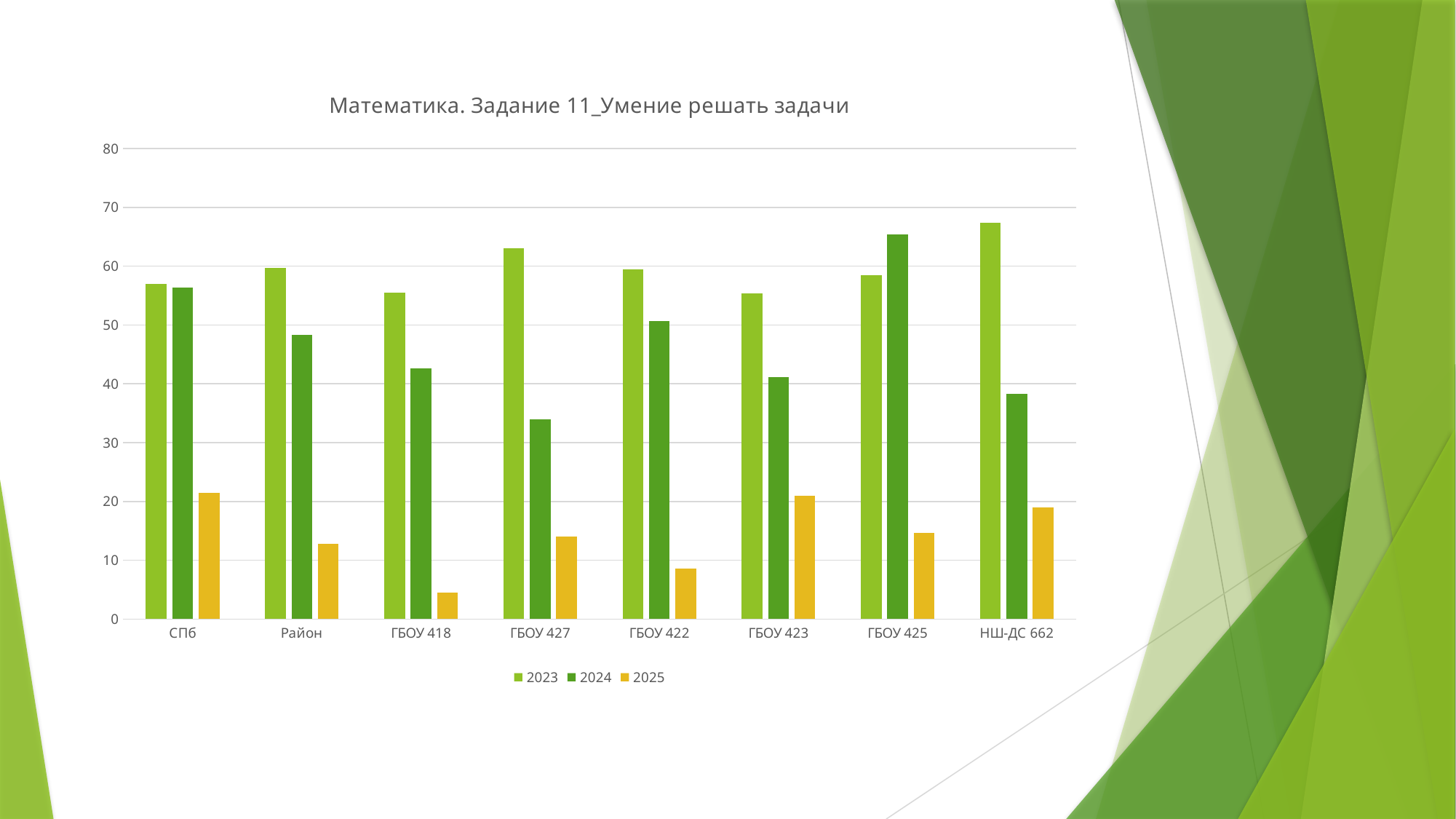
Is the 2025 value for ГБОУ 418 greater or less than 10? less Which category has the highest value for the 2023 series? НШ-ДС 662 Which category has the lowest value for the 2025 series? ГБОУ 418 What kind of chart is shown on the slide? bar chart Which category has the highest value for the 2024 series? ГБОУ 425 Which series is shown in yellow in the legend? 2025 How many series does the legend list? 3 How many categories are shown on the x axis? 8 What is the title of the chart? Математика. Задание 11_Умение решать задачи For ГБОУ 425, which is larger: the 2023 value or the 2024 value? 2024 Which category has the lowest value for the 2024 series? ГБОУ 427 Is the 2023 value for ГБОУ 427 greater or less than 60? greater